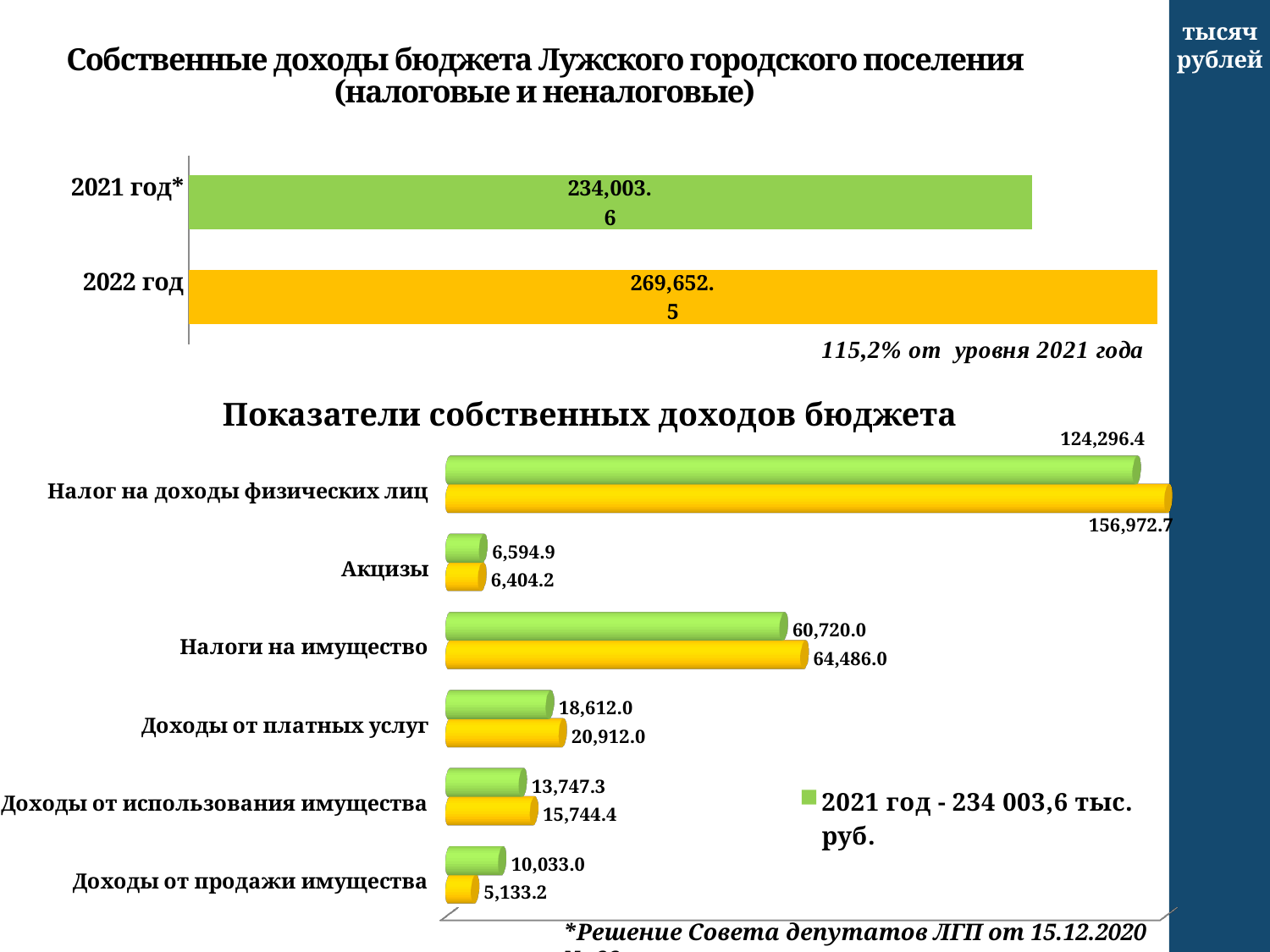
In the bottom chart 'Показатели собственных доходов бюджета', what is the 2021 (green) value for Налоги на имущество? 60,720.0 What kind of chart is the top chart 'Собственные доходы бюджета Лужского городского поселения'? Bar chart In the bottom chart 'Показатели собственных доходов бюджета', what is the difference between the 2022 and 2021 values for Налог на доходы физических лиц? 32,676.3 In the top chart 'Собственные доходы бюджета Лужского городского поселения', what is the difference between the 2022 год and 2021 год* values? 35,648.9 In the bottom chart 'Показатели собственных доходов бюджета', which category has the highest 2022 (yellow) value? Налог на доходы физических лиц In the bottom chart 'Показатели собственных доходов бюджета', what is the 2022 (yellow) value for Налог на доходы физических лиц? 156,972.7 In the top chart 'Собственные доходы бюджета Лужского городского поселения', what is the value for 2021 год*? 234,003.6 In the bottom chart 'Показатели собственных доходов бюджета', which is larger for Доходы от продажи имущества: the 2021 (green) value or the 2022 (yellow) value? 2021 (green) In the bottom chart 'Показатели собственных доходов бюджета', what is the 2022 (yellow) value for Доходы от продажи имущества? 5,133.2 In the bottom chart 'Показатели собственных доходов бюджета', how many categories are shown? 6 In the bottom chart 'Показатели собственных доходов бюджета', which category has the lowest 2022 (yellow) value? Доходы от продажи имущества In the top chart 'Собственные доходы бюджета Лужского городского поселения', what is the value for 2022 год? 269,652.5